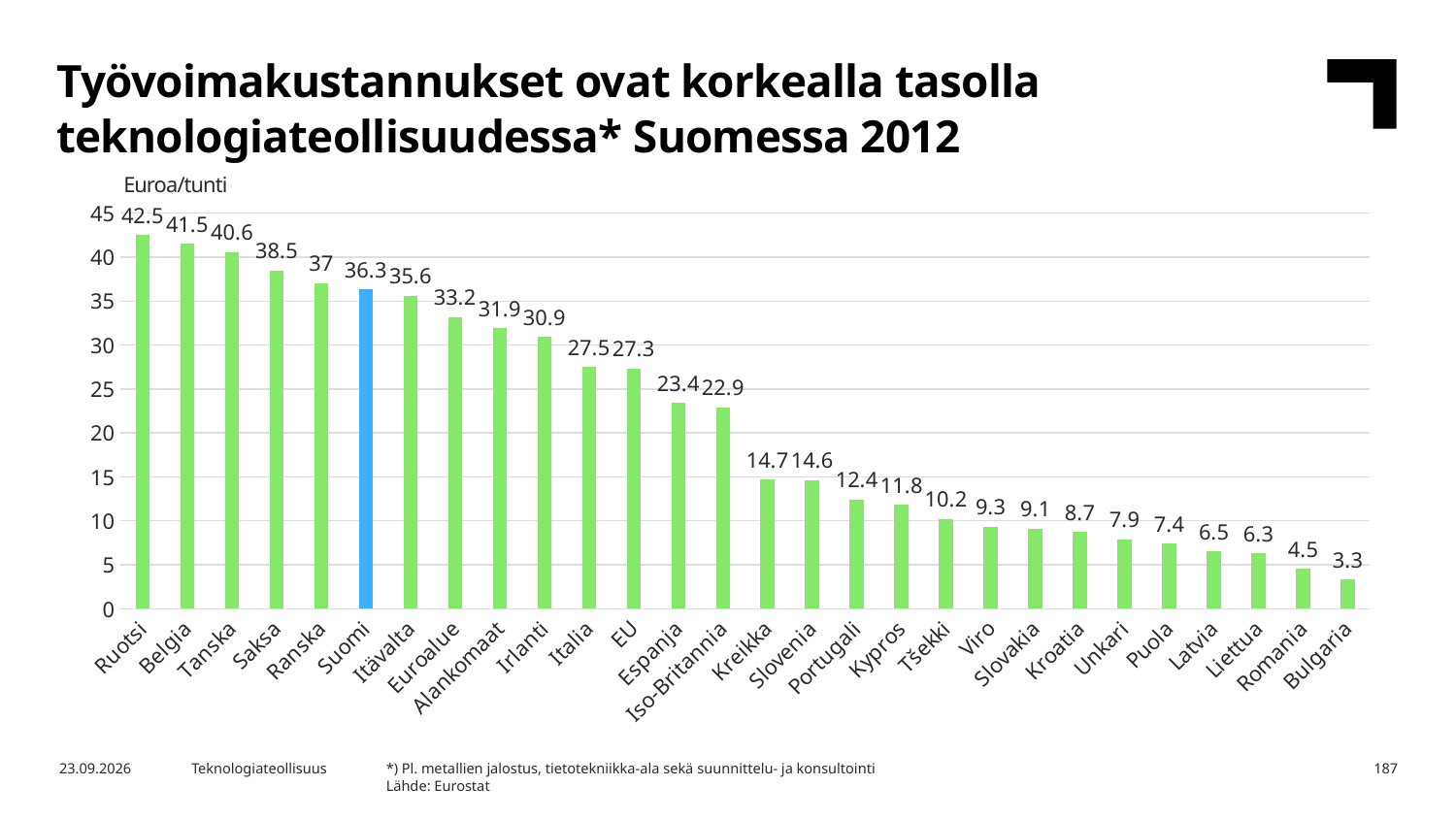
Which is larger, the value for Saksa or the value for Ranska? Saksa Do the values rise or fall from left to right along the x axis? Fall Which country has the lowest labour cost per hour? Bulgaria What is the value for Viro? 9.3 How many categories are shown on the x axis? 28 What kind of chart is shown on the slide? Bar chart Which country's bar is coloured blue instead of green? Suomi What is the difference between the values for Ruotsi and Suomi? 6.2 What is the difference between the values for Suomi and EU? 9 What is the value for Suomi? 36.3 What is the value for Euroalue? 33.2 Which country has the highest labour cost per hour? Ruotsi